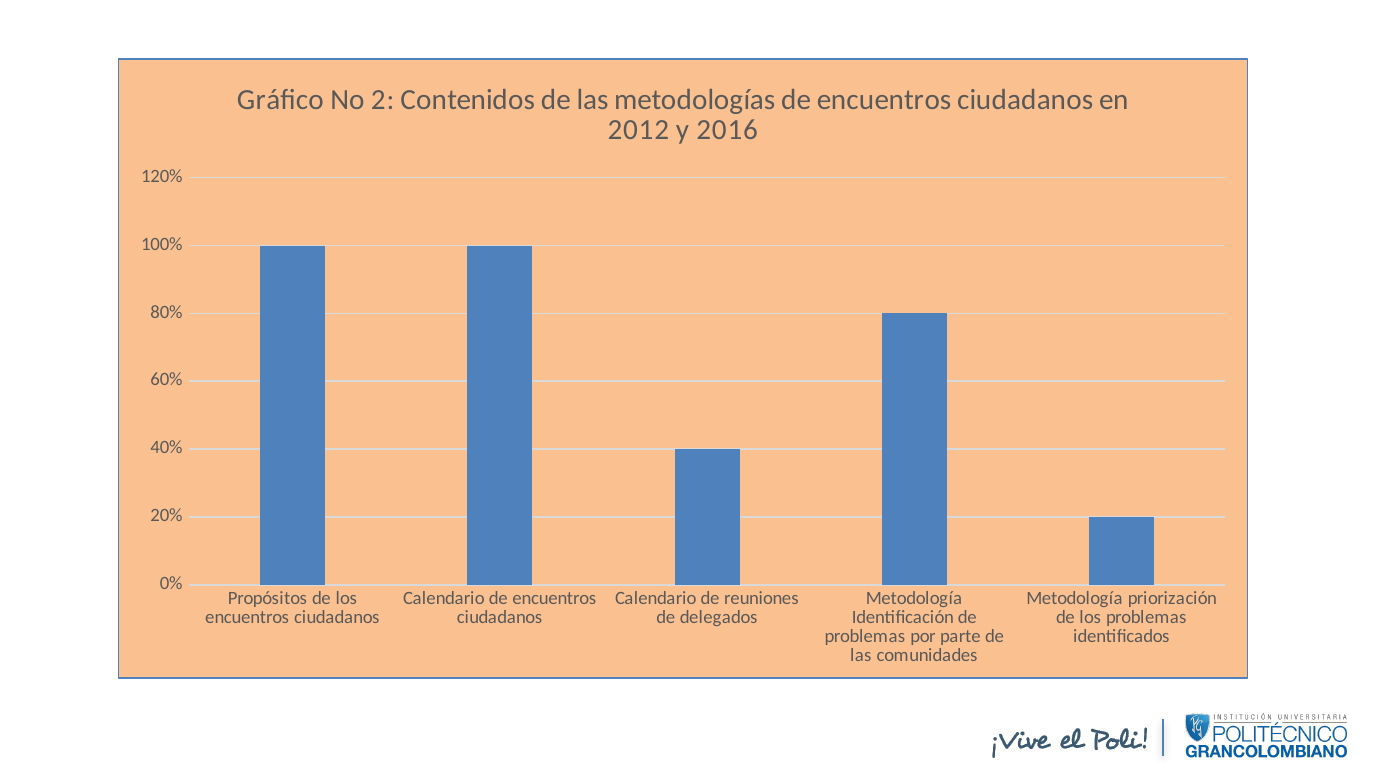
What is the value for 'Metodología Identificación de problemas por parte de las comunidades'? 80% What is the value for 'Propósitos de los encuentros ciudadanos'? 100% Is the value for 'Metodología priorización de los problemas identificados' greater or less than 40%? less What is the title of the chart? Gráfico No 2: Contenidos de las metodologías de encuentros ciudadanos en 2012 y 2016 What type of chart is shown on the slide? bar chart What is the difference between the values for 'Calendario de encuentros ciudadanos' and 'Calendario de reuniones de delegados'? 60% Which is larger: the value for 'Calendario de reuniones de delegados' or the value for 'Metodología Identificación de problemas por parte de las comunidades'? Metodología Identificación de problemas por parte de las comunidades What is the highest value shown on the vertical axis? 120% How many categories are plotted in the chart? 5 What is the difference between the values for 'Metodología Identificación de problemas por parte de las comunidades' and 'Metodología priorización de los problemas identificados'? 60% Which category has the lowest value? Metodología priorización de los problemas identificados What is the value for 'Calendario de reuniones de delegados'? 40%